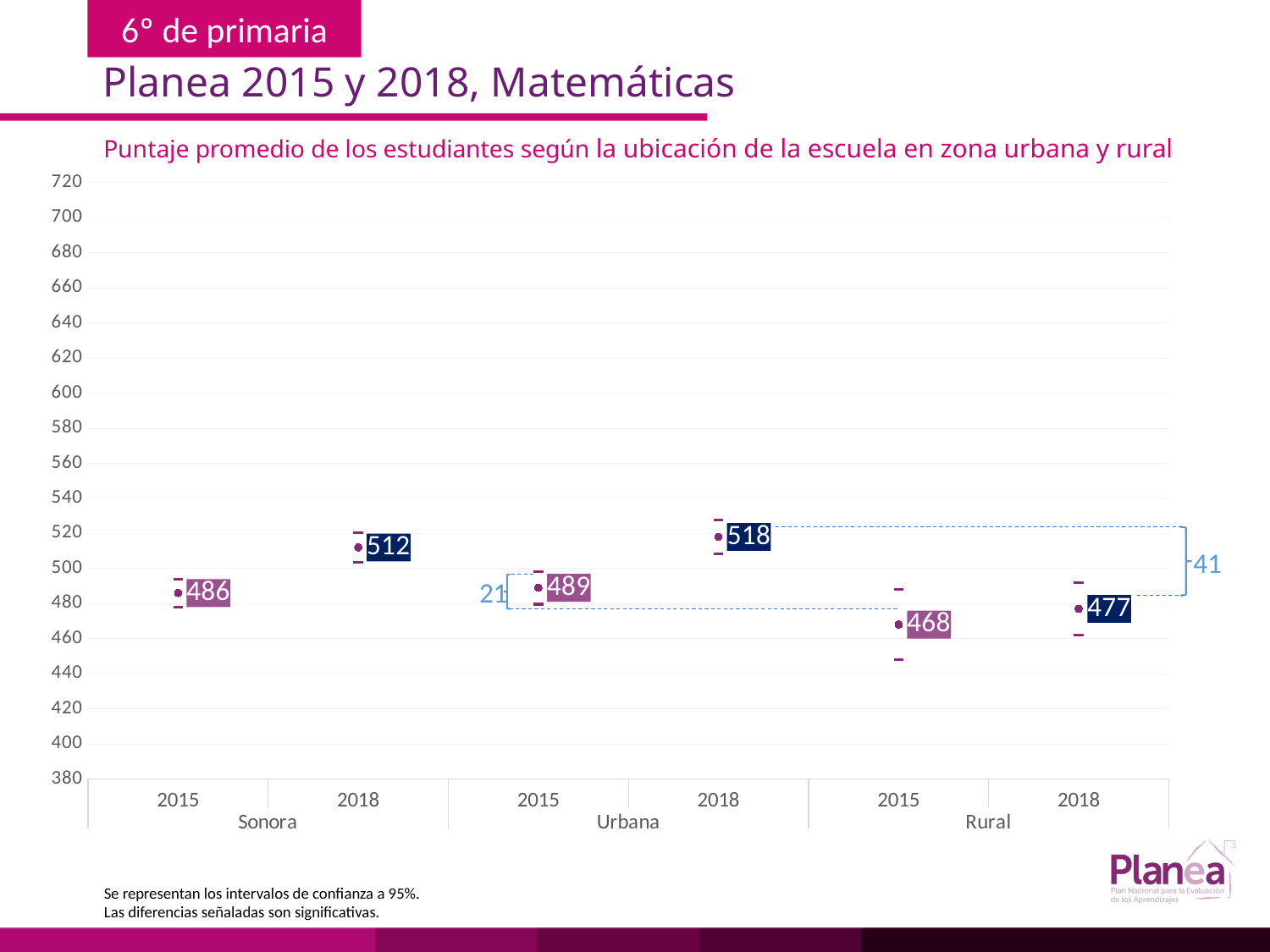
How many data points are plotted on the chart? 6 What is the average score for Sonora in 2015? 486 Did the average score rise or fall from 2015 to 2018 in each of the three groups? rise What is the average score for Rural in 2018? 477 Which category and year has the lowest average score? Rural 2015 What is the average score for Rural in 2015? 468 What is the difference between the Sonora 2018 score and the Sonora 2015 score? 26 What is the average score for Urbana in 2018? 518 What is the difference between the Urbana 2018 score and the Rural 2018 score? 41 Which is larger, the Urbana 2015 score or the Rural 2015 score? Urbana 2015 Is the value for Rural 2015 greater or less than 480? less Which category and year has the highest average score? Urbana 2018